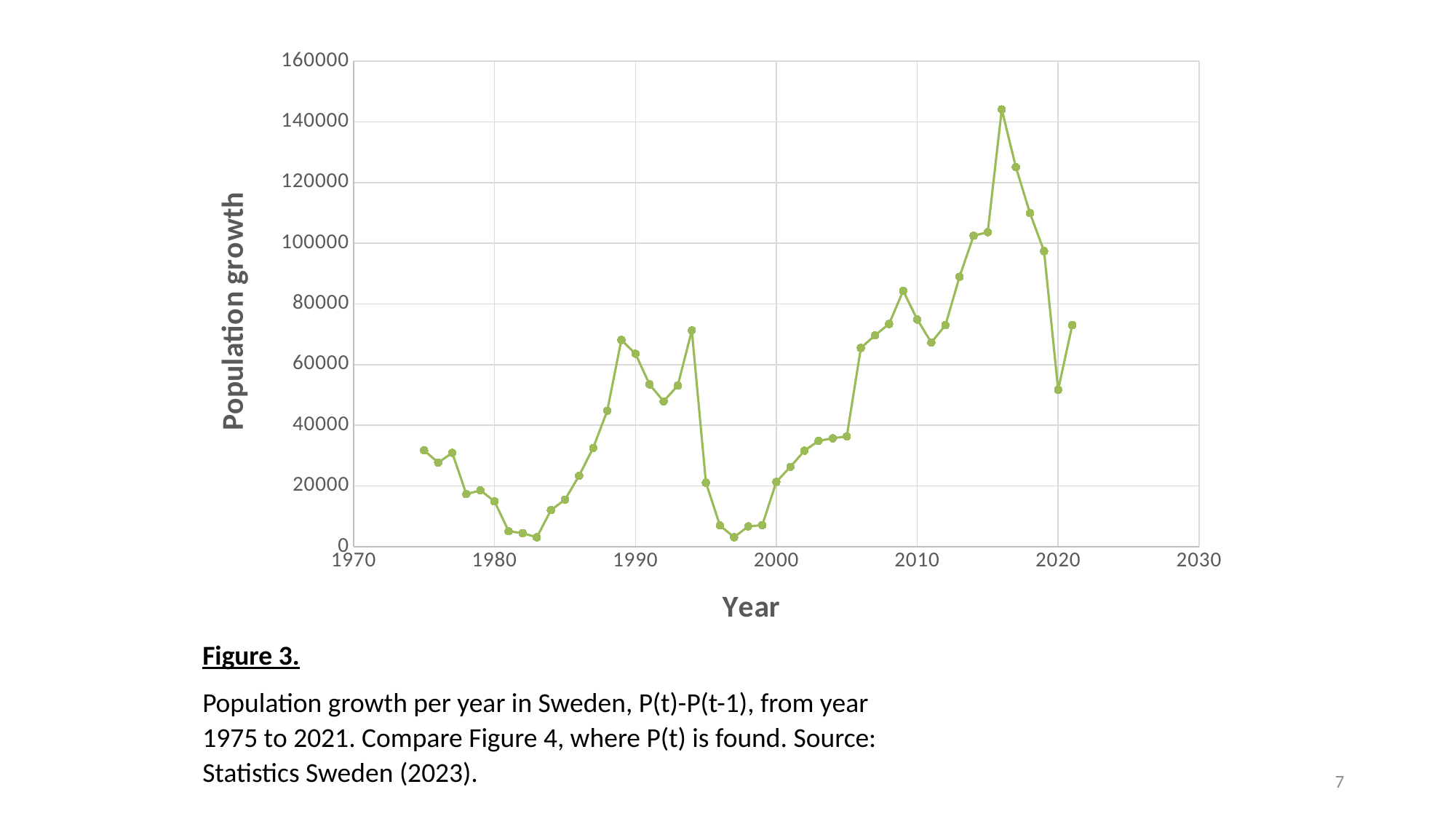
Is the population growth for 1994 greater or less than 60000? greater Is the population growth for 2017 greater or less than 120000? greater Is the population growth for 2016 greater or less than 140000? greater Which year has the highest population growth in the chart? 2016 Which year has the larger population growth, 1994 or 2009? 2009 Which year has the larger population growth, 2020 or 2021? 2021 Does population growth rise or fall from 2016 to 2020? fall What is the title of the vertical axis? Population growth What kind of chart is shown on the slide? line chart